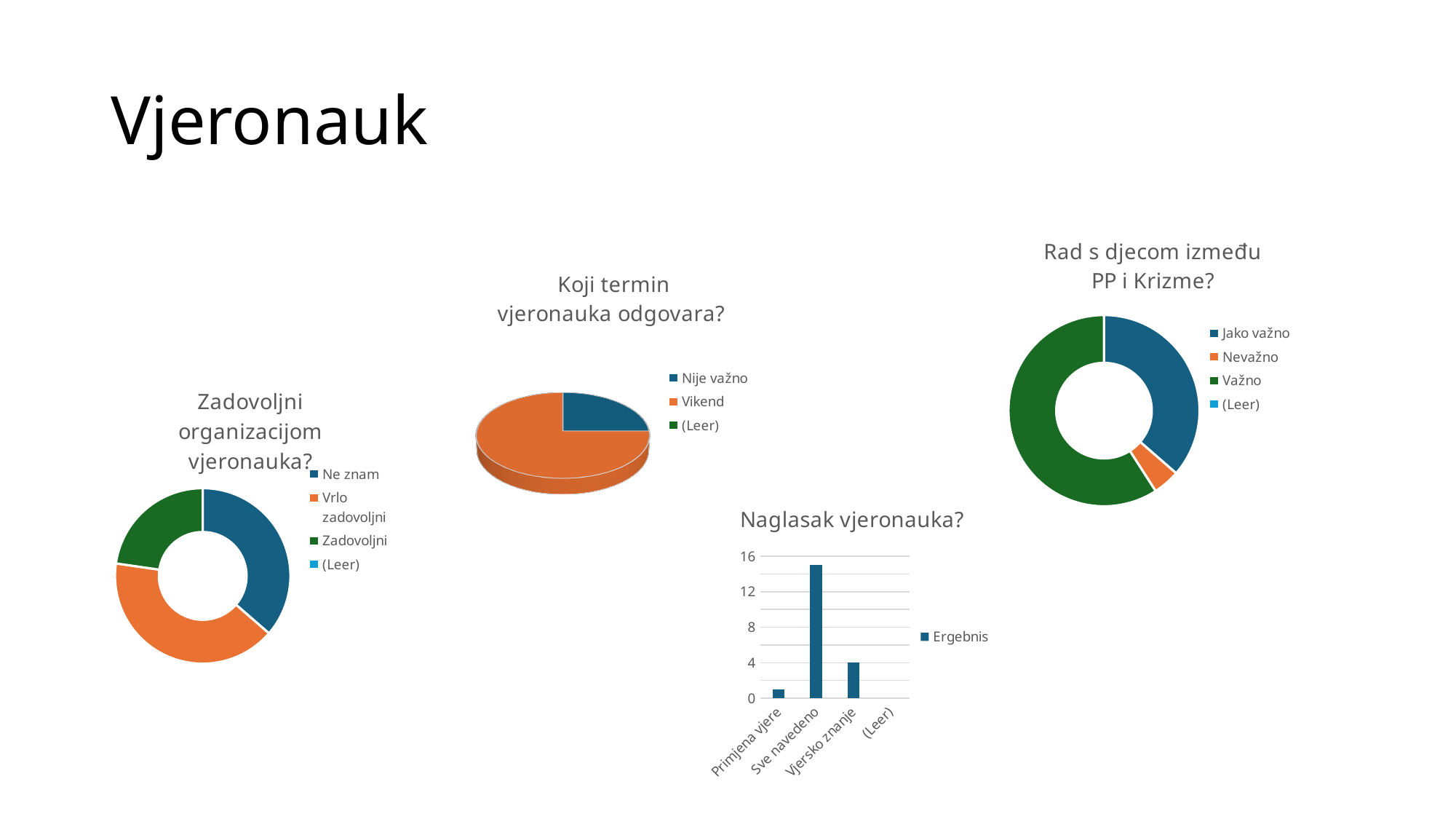
In the 'Zadovoljni organizacijom vjeronauka?' chart, which category has the smallest slice? Zadovoljni In the 'Naglasak vjeronauka?' chart, how many categories are shown on the x axis? 4 In the 'Naglasak vjeronauka?' chart, is the value for Sve navedeno greater or less than 12? greater In the 'Naglasak vjeronauka?' chart, what kind of chart is it? Bar chart In the 'Naglasak vjeronauka?' chart, is the value for Primjena vjere greater or less than 4? less In the 'Rad s djecom između PP i Krizme?' chart, how many entries does the legend list? 4 In the 'Naglasak vjeronauka?' chart, what is the value for Vjersko znanje? 4 In the 'Naglasak vjeronauka?' chart, which category has the highest value? Sve navedeno In the 'Koji termin vjeronauka odgovara?' chart, which category has the largest slice? Vikend In the 'Rad s djecom između PP i Krizme?' chart, which category has the smallest slice? Nevažno In the 'Koji termin vjeronauka odgovara?' chart, which is larger, Nije važno or Vikend? Vikend In the 'Naglasak vjeronauka?' chart, what is the name of the series in the legend? Ergebnis